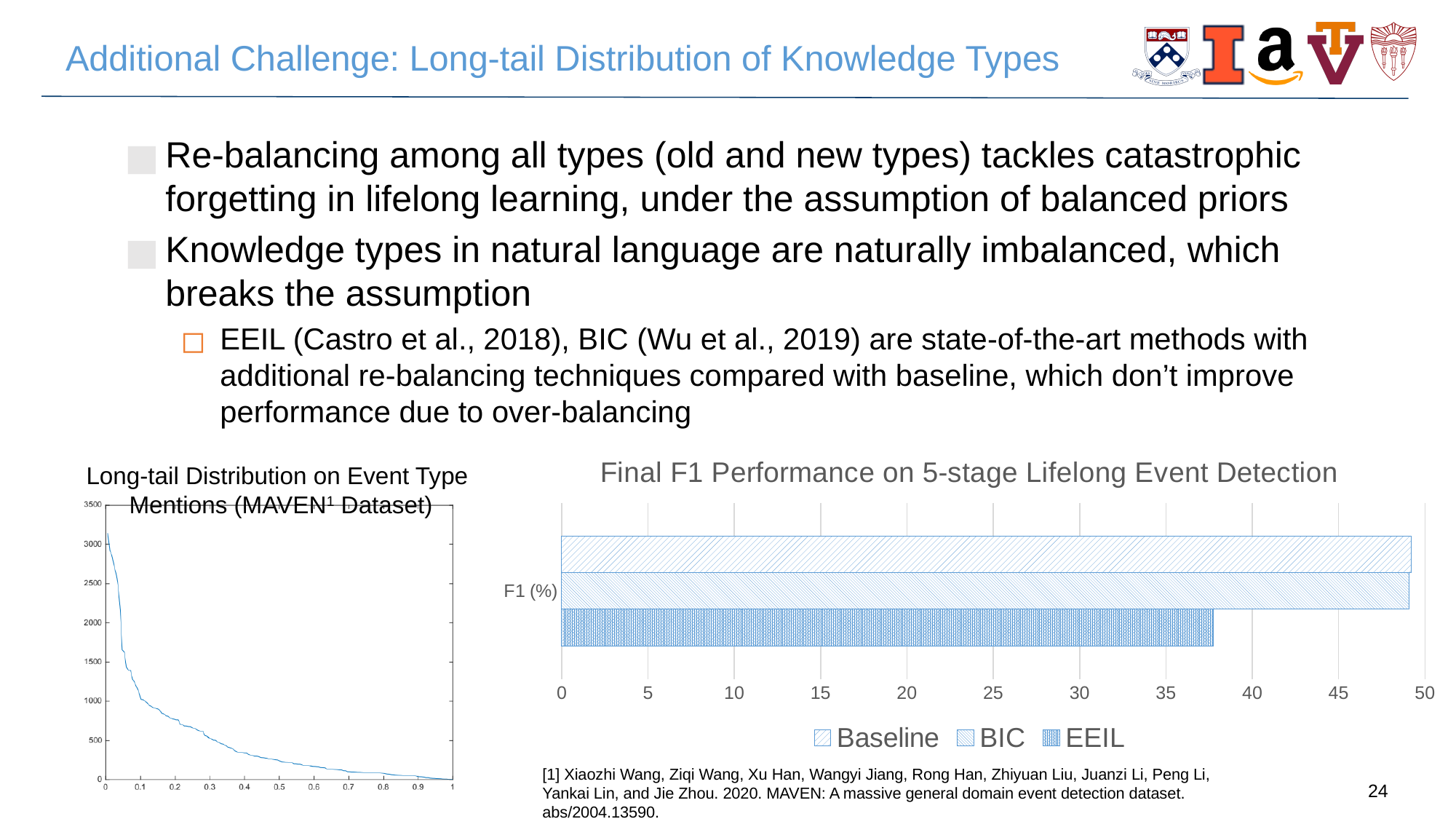
What kind of chart is the 'Long-tail Distribution on Event Type Mentions (MAVEN Dataset)' chart? line chart In the 'Final F1 Performance on 5-stage Lifelong Event Detection' chart, is the value for EEIL greater or less than 40? less How many series does the legend of the 'Final F1 Performance on 5-stage Lifelong Event Detection' chart list? 3 In the 'Final F1 Performance on 5-stage Lifelong Event Detection' chart, which series has the lowest F1 value? EEIL In the 'Long-tail Distribution on Event Type Mentions (MAVEN Dataset)' chart, do the values rise or fall along the x axis? fall In the 'Final F1 Performance on 5-stage Lifelong Event Detection' chart, what are the names of the three series in the legend? Baseline, BIC, EEIL In the 'Final F1 Performance on 5-stage Lifelong Event Detection' chart, is the value for EEIL greater or less than 35? greater In the 'Final F1 Performance on 5-stage Lifelong Event Detection' chart, which is larger, the value for Baseline or the value for EEIL? Baseline In the 'Long-tail Distribution on Event Type Mentions (MAVEN Dataset)' chart, is the value at x = 0.5 greater or less than 1000? less What kind of chart is the 'Final F1 Performance on 5-stage Lifelong Event Detection' chart? bar chart